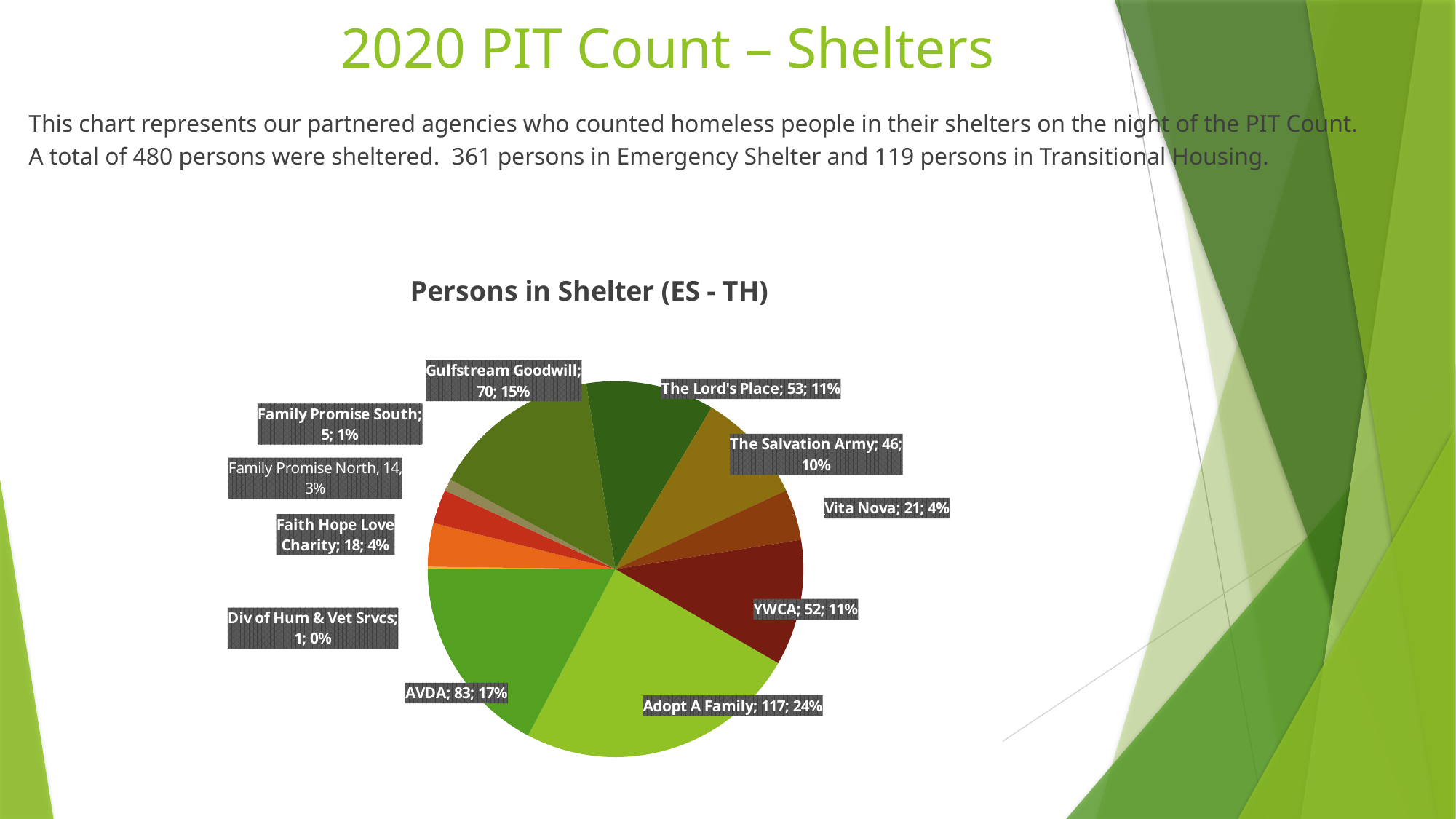
Which agency has the largest slice of the pie? Adopt A Family Which agency has the smallest slice of the pie? Div of Hum & Vet Srvcs How many agencies (slices) are shown in the pie chart? 11 What percentage share of the pie does The Salvation Army have? 10% What kind of chart is shown on the slide? Pie chart What is the difference in persons between Adopt A Family and AVDA? 34 Which has more persons, The Lord's Place or The Salvation Army? The Lord's Place What is the title of the chart? Persons in Shelter (ES - TH) How many persons are shown for Family Promise North? 14 How many persons are shown for Adopt A Family? 117 What percentage share of the pie does AVDA have? 17% How many persons are shown for Gulfstream Goodwill? 70